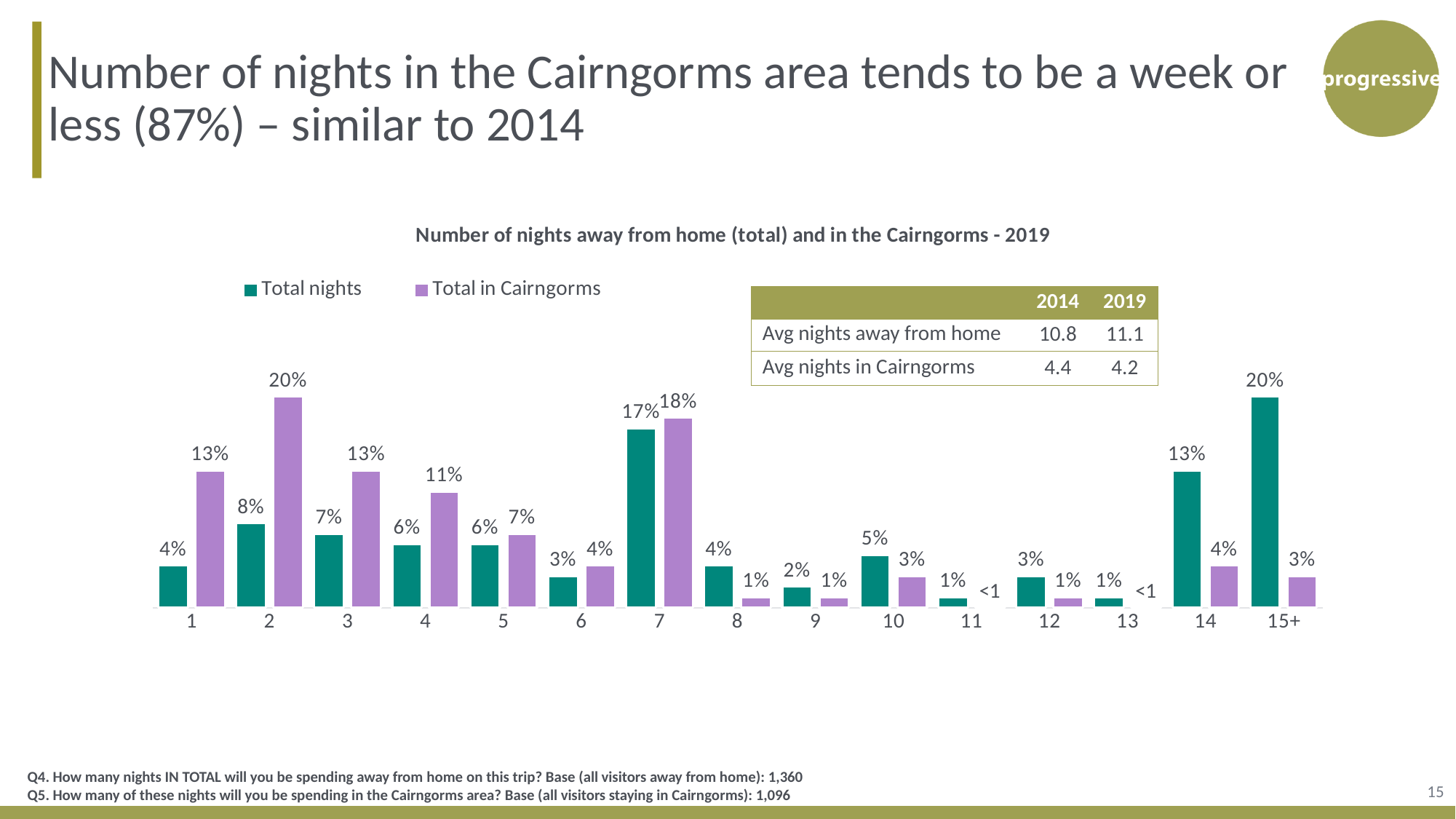
At 15+ nights, which is larger: Total nights or Total in Cairngorms? Total nights What is the difference between Total in Cairngorms and Total nights at 1 night? 9% Which category has the highest value for Total in Cairngorms? 2 According to the table, what was the average number of nights in the Cairngorms in 2019? 4.2 What is the value for Total in Cairngorms at 2 nights? 20% What is the value for Total nights at 14 nights? 13% How many series does the chart legend list? 2 What type of chart is shown on the slide? bar chart What is the value for Total nights at 7 nights? 17% Which category has the highest value for Total nights? 15+ What is the title of the chart? Number of nights away from home (total) and in the Cairngorms - 2019 How many categories are shown along the x axis of the chart? 15